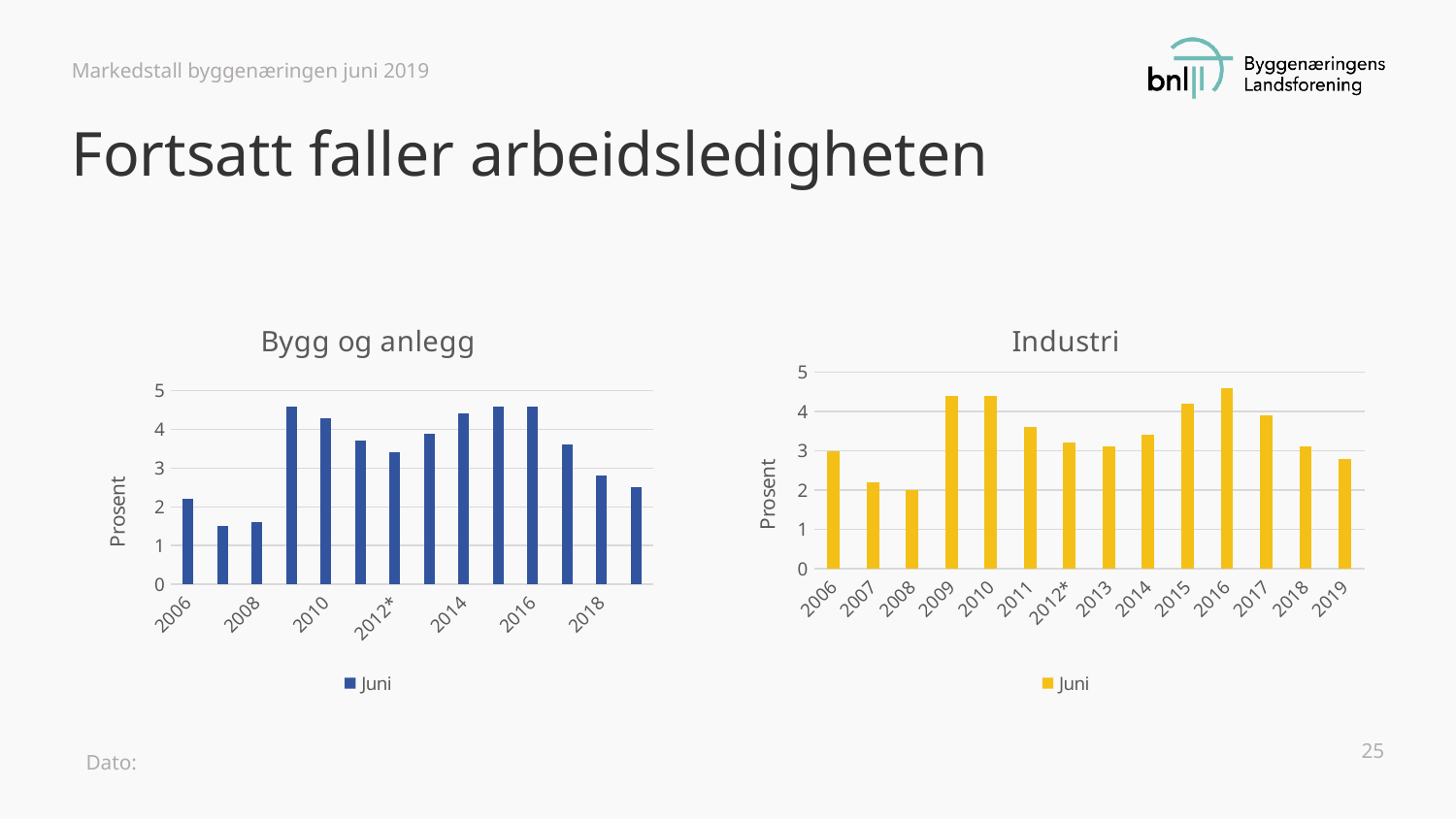
In the "Industri" chart, which year has the highest value? 2016 In the "Bygg og anlegg" chart, is the value for 2010 greater or less than 4? greater In the "Industri" chart, which year has the lowest value? 2008 In the "Industri" chart, is the value for 2009 greater or less than 4? greater What kind of chart is the "Bygg og anlegg" chart? Bar chart How many bars are plotted in the "Industri" chart? 14 In the "Bygg og anlegg" chart, is the value for 2018 greater or less than 3? less In the "Bygg og anlegg" chart, do the values rise or fall from 2016 to 2018? Fall How many series does the legend of the "Industri" chart list? 1 In the "Industri" chart, which is larger, the value for 2016 or the value for 2019? 2016 What is the legend entry shown under the "Industri" chart? Juni